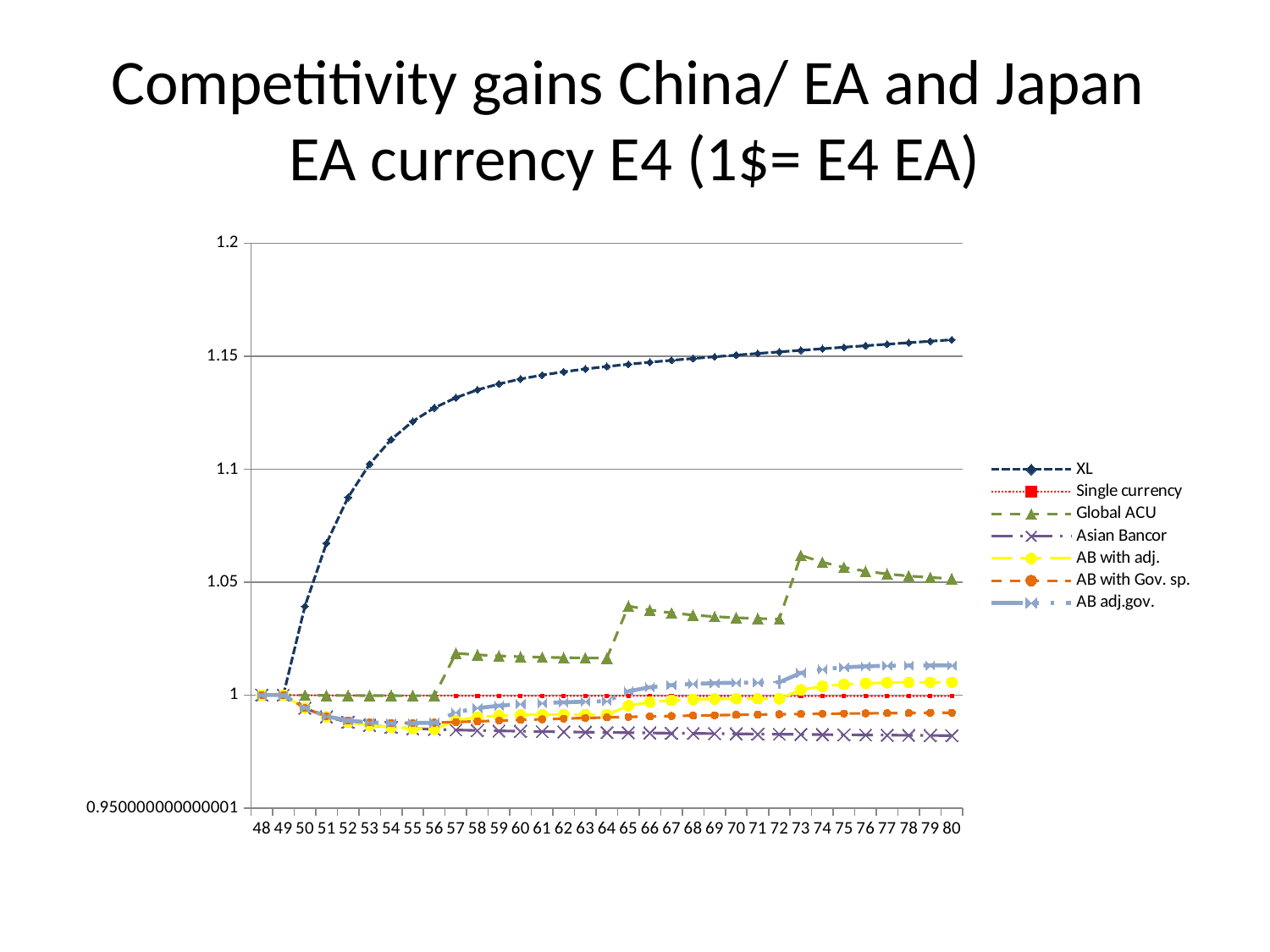
Which series has the lowest value at x = 80? Asian Bancor What is the title of the chart on the slide? Competitivity gains China/ EA and Japan EA currency E4 (1$= E4 EA) Which series has the highest value at x = 80? XL Does the XL series rise or fall from x = 49 to x = 80? rise How many series does the legend list? 7 At x = 80, which series is larger: Global ACU or Asian Bancor? Global ACU Is the value of the Global ACU series at x = 73 greater or less than 1.05? greater Is the value of the XL series at x = 80 greater or less than 1.15? greater Is the value of the XL series at x = 52 greater or less than 1.1? less What kind of chart is shown on the slide? line chart How many points are on the x axis (from 48 to 80)? 33